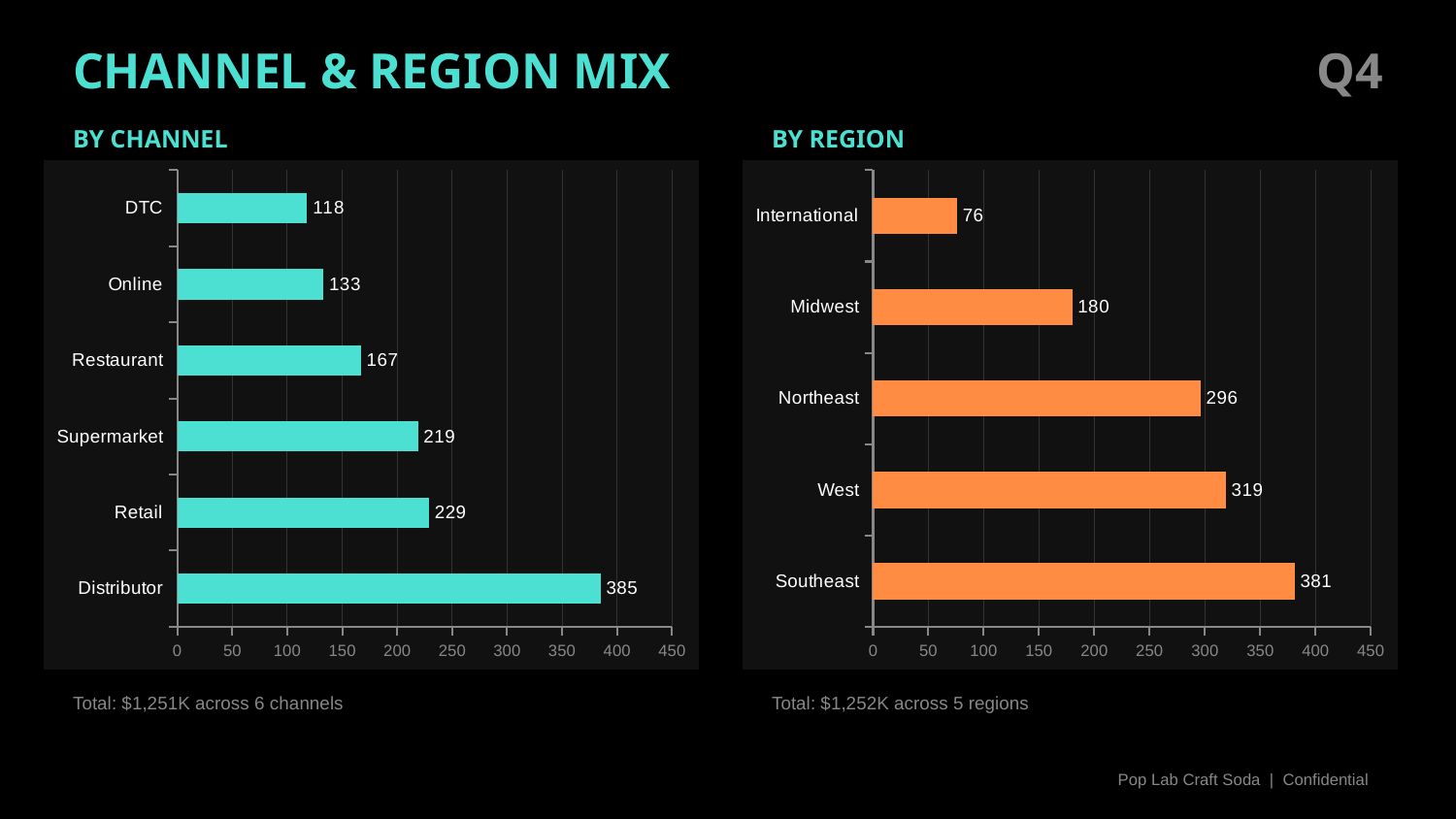
In the BY REGION chart, which region has the lowest value? International What colour are the bars in the BY CHANNEL chart? Teal In the BY CHANNEL chart, which channel has the lowest value? DTC In the BY CHANNEL chart, which channel has the highest value? Distributor What kind of chart is the BY REGION chart? Bar chart In the BY CHANNEL chart, how many channels are shown? 6 In the BY REGION chart, how many regions are shown? 5 In the BY REGION chart, which is larger, West or Midwest? West In the BY CHANNEL chart, what is the value for Supermarket? 219 In the BY CHANNEL chart, what is the difference between Retail and Online? 96 In the BY REGION chart, what is the difference between Southeast and International? 305 In the BY REGION chart, what is the value for Northeast? 296